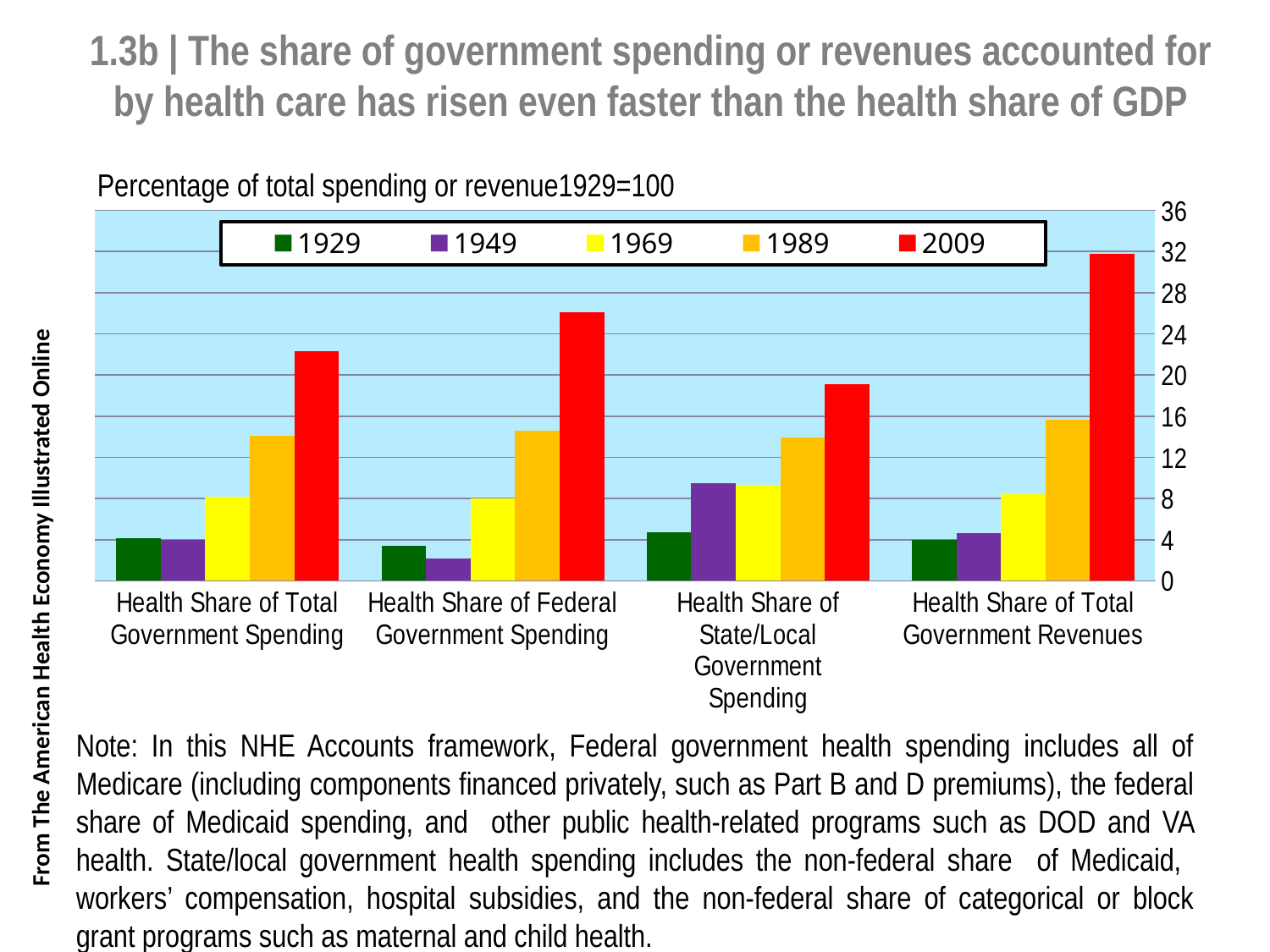
For Health Share of Total Government Revenues, do the values rise or fall from 1929 to 2009? rise Is the 1949 value for Health Share of Federal Government Spending greater or less than 4? less How many categories are shown along the x axis? 4 How many series does the legend list? 5 Which category has the tallest 2009 bar? Health Share of Total Government Revenues Which category has the lowest 1949 bar? Health Share of Federal Government Spending Which is larger, the 2009 value for Health Share of Federal Government Spending or the 2009 value for Health Share of Total Government Spending? Health Share of Federal Government Spending Is the 2009 value for Health Share of State/Local Government Spending greater or less than 20? less Is the 1989 value for Health Share of Total Government Spending greater or less than 12? greater What kind of chart is shown on the slide? bar chart Which colour represents the 2009 series in the legend? red